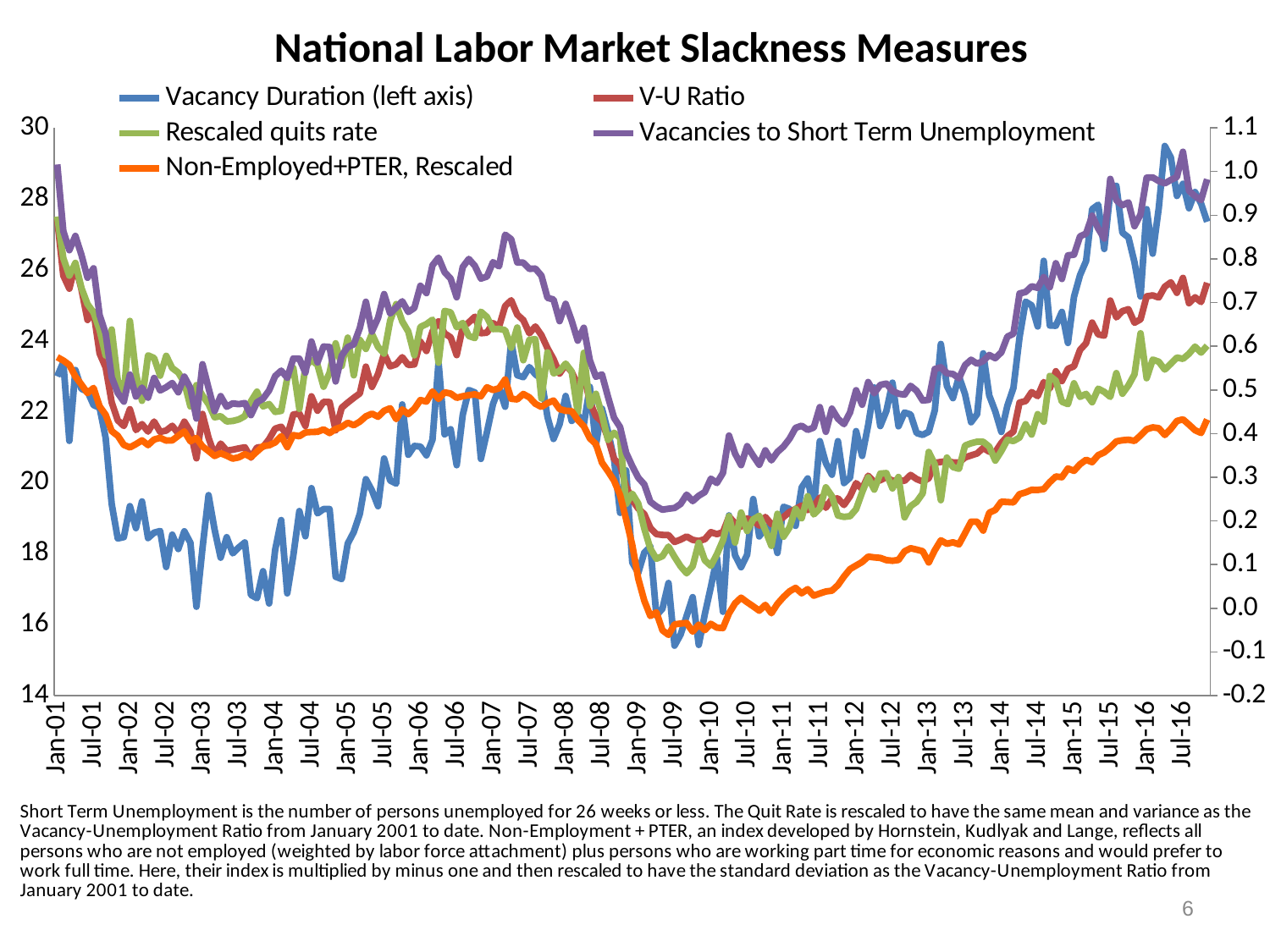
Is the value of Vacancy Duration at Jul-09 greater or less than 18? less Does the V-U Ratio rise or fall from Jan-08 to Jul-09? fall What is the title of the chart? National Labor Market Slackness Measures Does the Non-Employed+PTER, Rescaled series rise or fall from Jan-10 to Jul-16? rise What kind of chart is shown on the slide? Line chart At Jul-16, which is higher: Vacancies to Short Term Unemployment or the V-U Ratio? Vacancies to Short Term Unemployment Which series is plotted against the left axis? Vacancy Duration Is the value of Vacancies to Short Term Unemployment at Jan-16 greater or less than 0.9? greater Which series reaches the lowest value on the right axis over the period shown? Non-Employed+PTER, Rescaled How many series does the legend list? 5 Is the value of the V-U Ratio at Jul-09 greater or less than 0.2? less